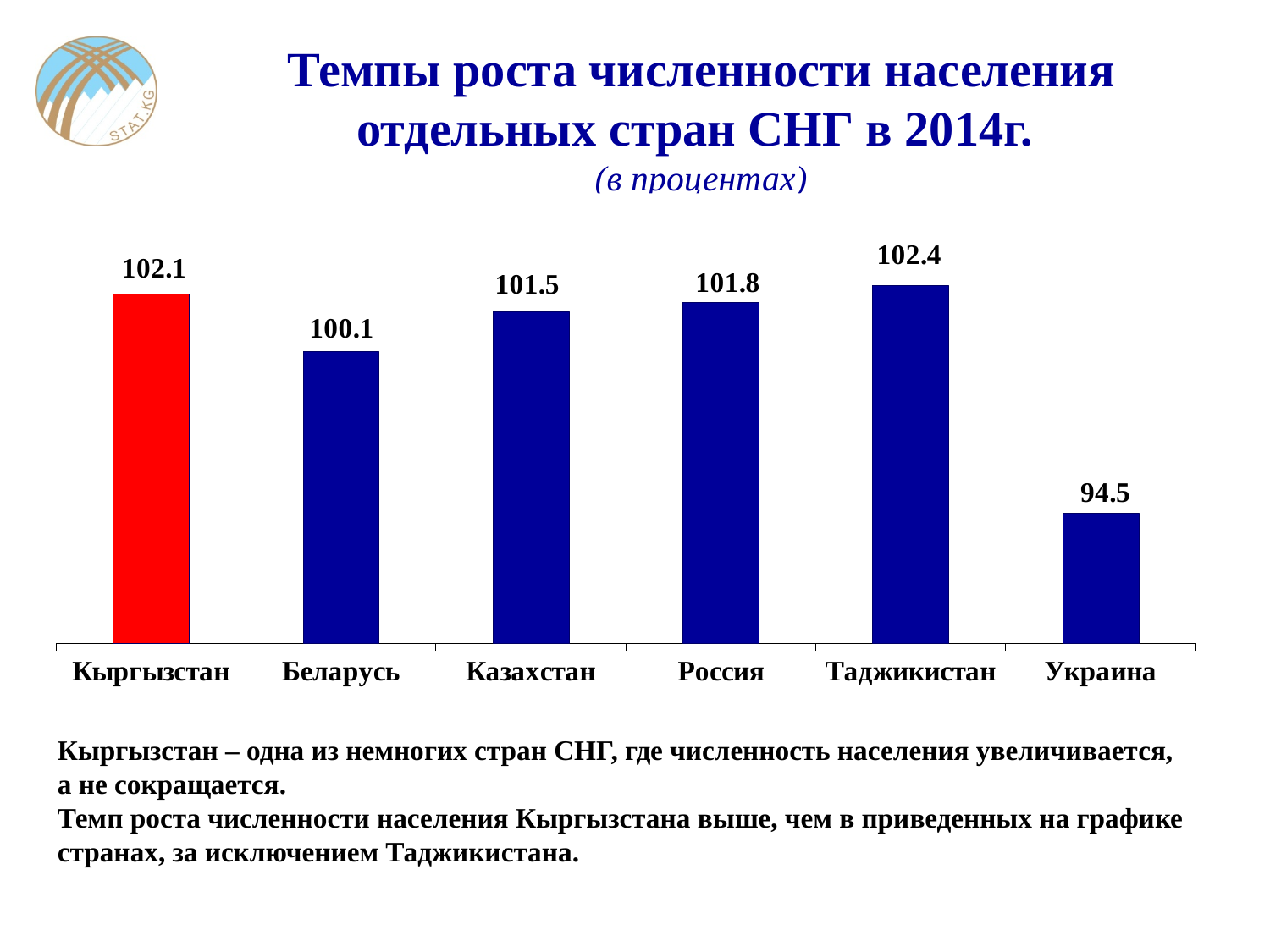
What is the difference between the values for Таджикистан and Кыргызстан? 0.3 Which has a larger value, Казахстан or Россия? Россия What value is shown for Украина? 94.5 How many countries are shown on the chart? 6 What value is shown for Россия? 101.8 What kind of chart is shown on the slide? Bar chart Which country has the lowest value on the chart? Украина What value is shown for Беларусь? 100.1 What is the population growth rate shown for Кыргызстан? 102.1 What is the difference between the values for Кыргызстан and Украина? 7.6 Which country has the highest value on the chart? Таджикистан Which country's bar is coloured red? Кыргызстан